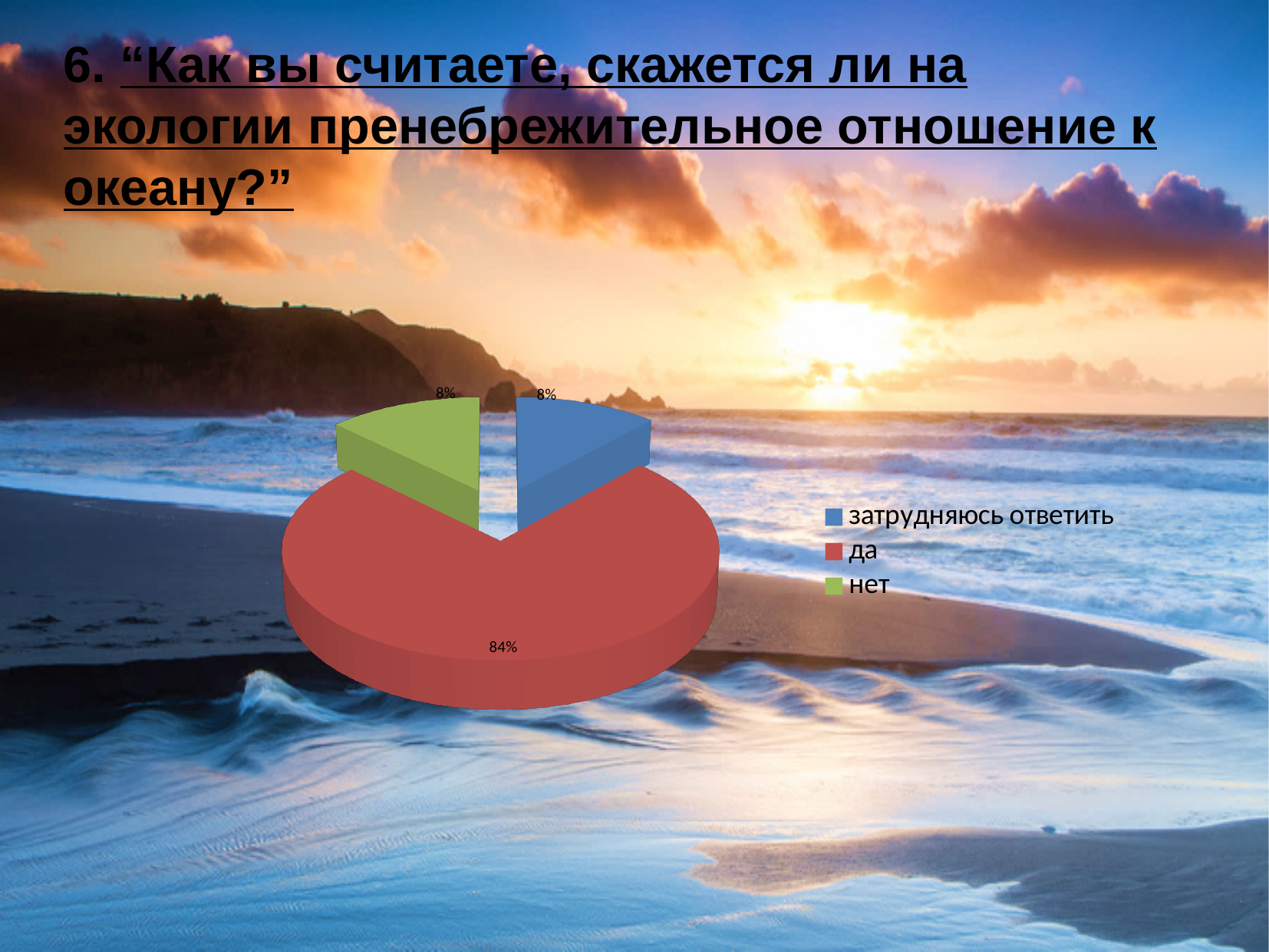
What colour is the "да" slice in the pie chart? red What share of the pie does the "да" slice represent? 84% Which legend entry is shown in green? нет How many slices does the pie chart have? 3 What share of the pie does the "затрудняюсь ответить" slice represent? 8% Which category has the largest slice of the pie? да What kind of chart is shown on the slide? pie chart How many entries does the legend list? 3 Which is larger, the share for "да" or the share for "затрудняюсь ответить"? да What share of the pie does the "нет" slice represent? 8% What is the difference between the share for "да" and the share for "нет"? 76% What is the combined share of the "нет" and "затрудняюсь ответить" slices? 16%